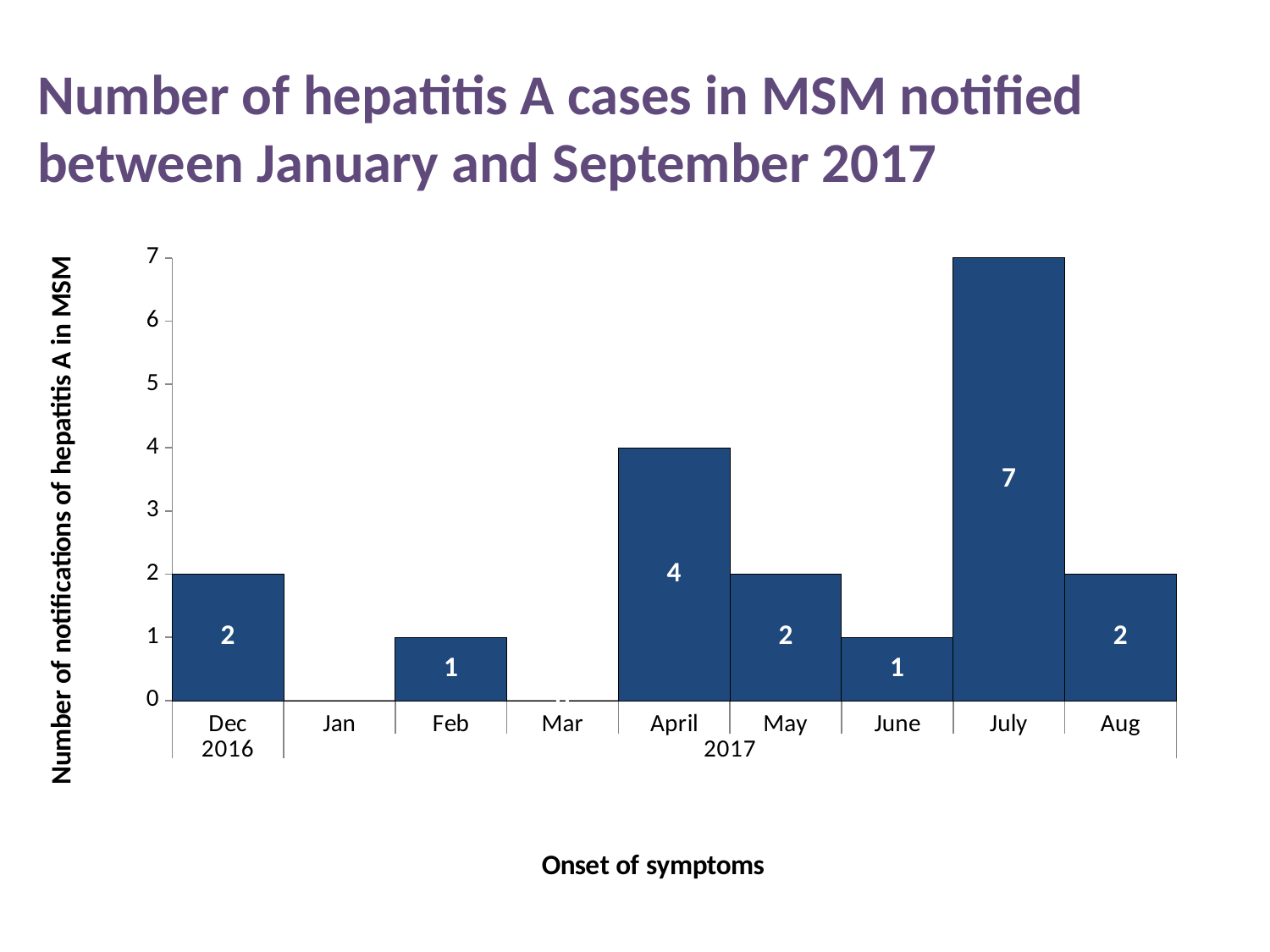
What is the number of hepatitis A notifications in MSM for April? 4 Which month has more notifications, April or May? April Is the value for July greater or less than 5? greater What is the difference between the number of notifications in July and in April? 3 What is the number of hepatitis A notifications in MSM for Dec 2016? 2 What is the label of the x axis of the chart? Onset of symptoms What is the number of hepatitis A notifications in MSM for July? 7 What is the label of the y axis of the chart? Number of notifications of hepatitis A in MSM Which month has the highest number of hepatitis A notifications in MSM? July How many months are shown on the x axis of the chart? 9 What kind of chart is shown on the slide? bar chart What is the number of hepatitis A notifications in MSM for June? 1